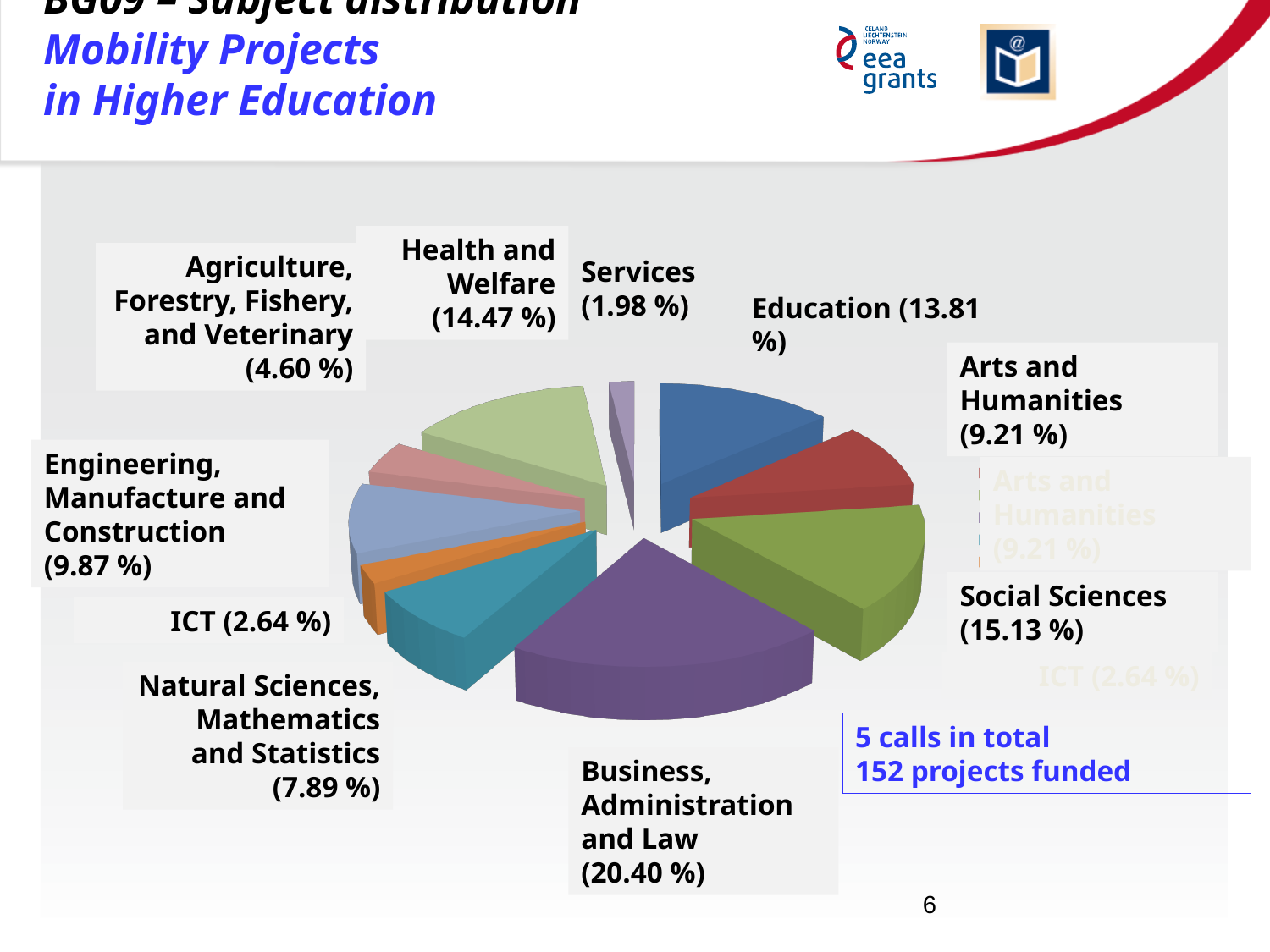
What is the value shown for Social Sciences? 15.13 % Which subject area has the smallest share of the pie? Services Which subject area has the largest share of the pie? Business, Administration and Law What share of the pie does Business, Administration and Law have? 20.40 % What is the value for Engineering, Manufacture and Construction? 9.87 % According to the text box on the slide, how many projects were funded? 152 What percentage is shown for Agriculture, Forestry, Fishery, and Veterinary? 4.60 % Which has a larger share, Education or Arts and Humanities? Education What kind of chart is shown on the slide? Pie chart What is the difference in percentage points between Social Sciences and Health and Welfare? 0.66 What percentage is shown for Health and Welfare? 14.47 % How many subject areas are shown in the pie chart? 10